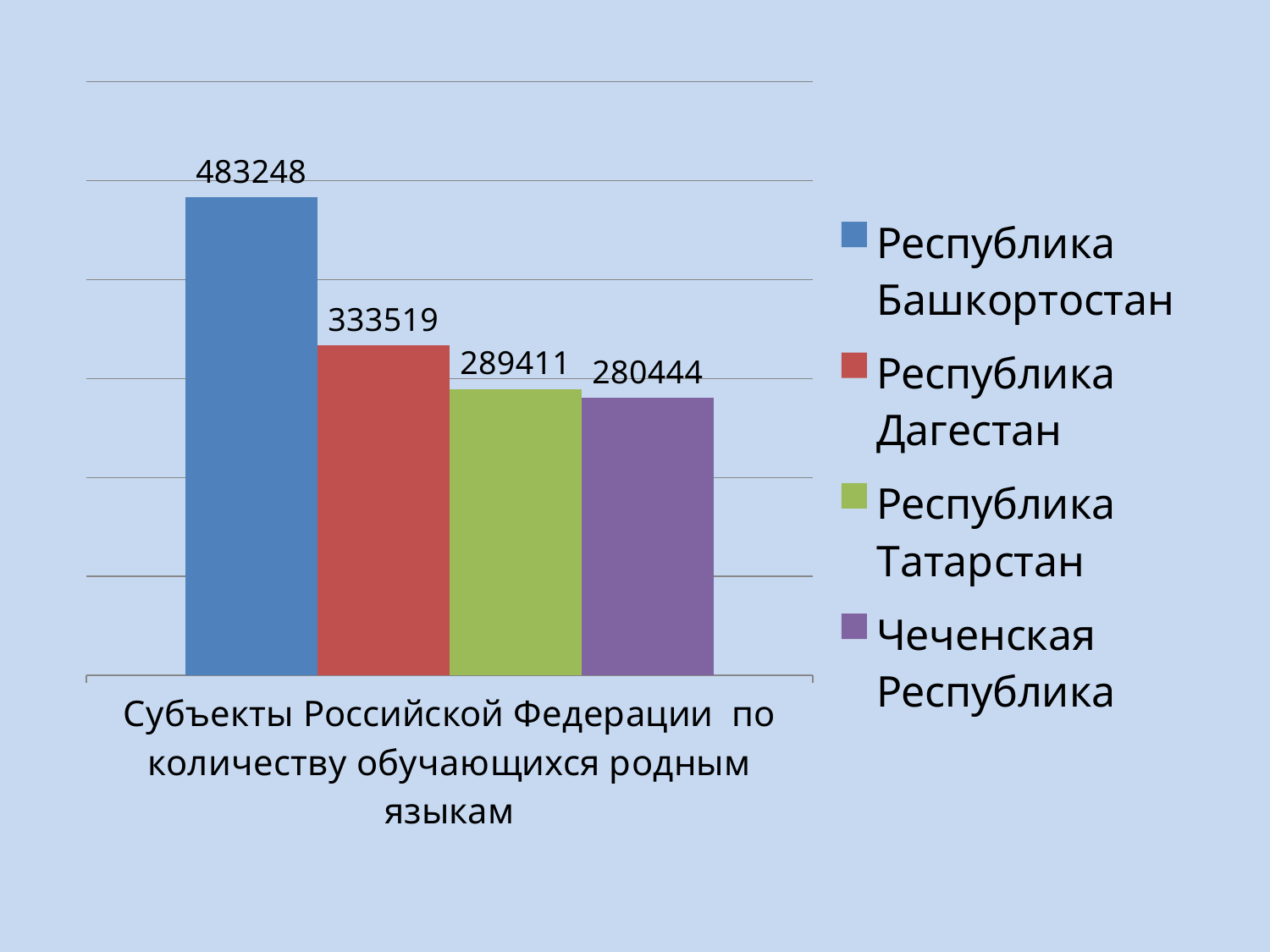
What kind of chart is shown on the slide? Bar chart What is the value for Республика Башкортостан? 483248 Which region has the highest value? Республика Башкортостан What is the value for Республика Дагестан? 333519 What is the difference between the values for Республика Башкортостан and Республика Дагестан? 149729 What is the difference between the values for Республика Татарстан and Чеченская Республика? 8967 How many series does the legend list? 4 What is the value for Чеченская Республика? 280444 Which region has the lowest value? Чеченская Республика What is the value for Республика Татарстан? 289411 Which is larger, the value for Республика Дагестан or the value for Республика Татарстан? Республика Дагестан What colour is the bar for Республика Татарстан? Green